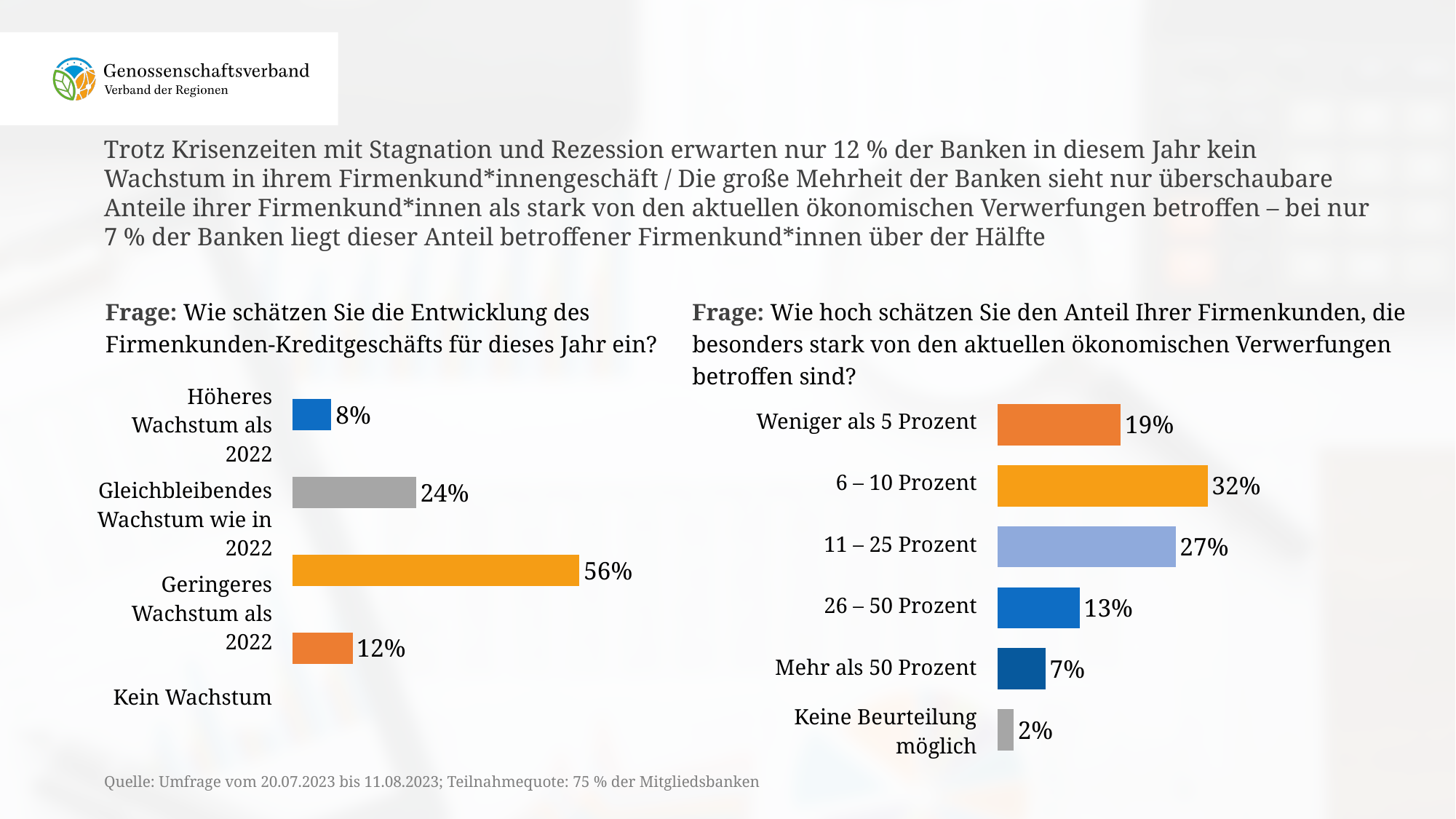
What type of chart is the right chart? Bar chart How many categories are shown in the left chart? 4 In the left chart, what is the value for 'Kein Wachstum'? 12% In the left chart, which category has the highest value? Geringeres Wachstum als 2022 In the right chart, what is the difference between '6 – 10 Prozent' and '26 – 50 Prozent'? 19% In the right chart, which is larger: 'Weniger als 5 Prozent' or '11 – 25 Prozent'? 11 – 25 Prozent In the left chart, what is the difference between 'Gleichbleibendes Wachstum wie in 2022' and 'Höheres Wachstum als 2022'? 16% In the right chart, what is the value for '6 – 10 Prozent'? 32% In the left chart, what percentage of banks expect 'Geringeres Wachstum als 2022'? 56% In the right chart, what is the value for 'Mehr als 50 Prozent'? 7% In the right chart, which category has the lowest value? Keine Beurteilung möglich In the left chart, which category has the lowest value? Höheres Wachstum als 2022